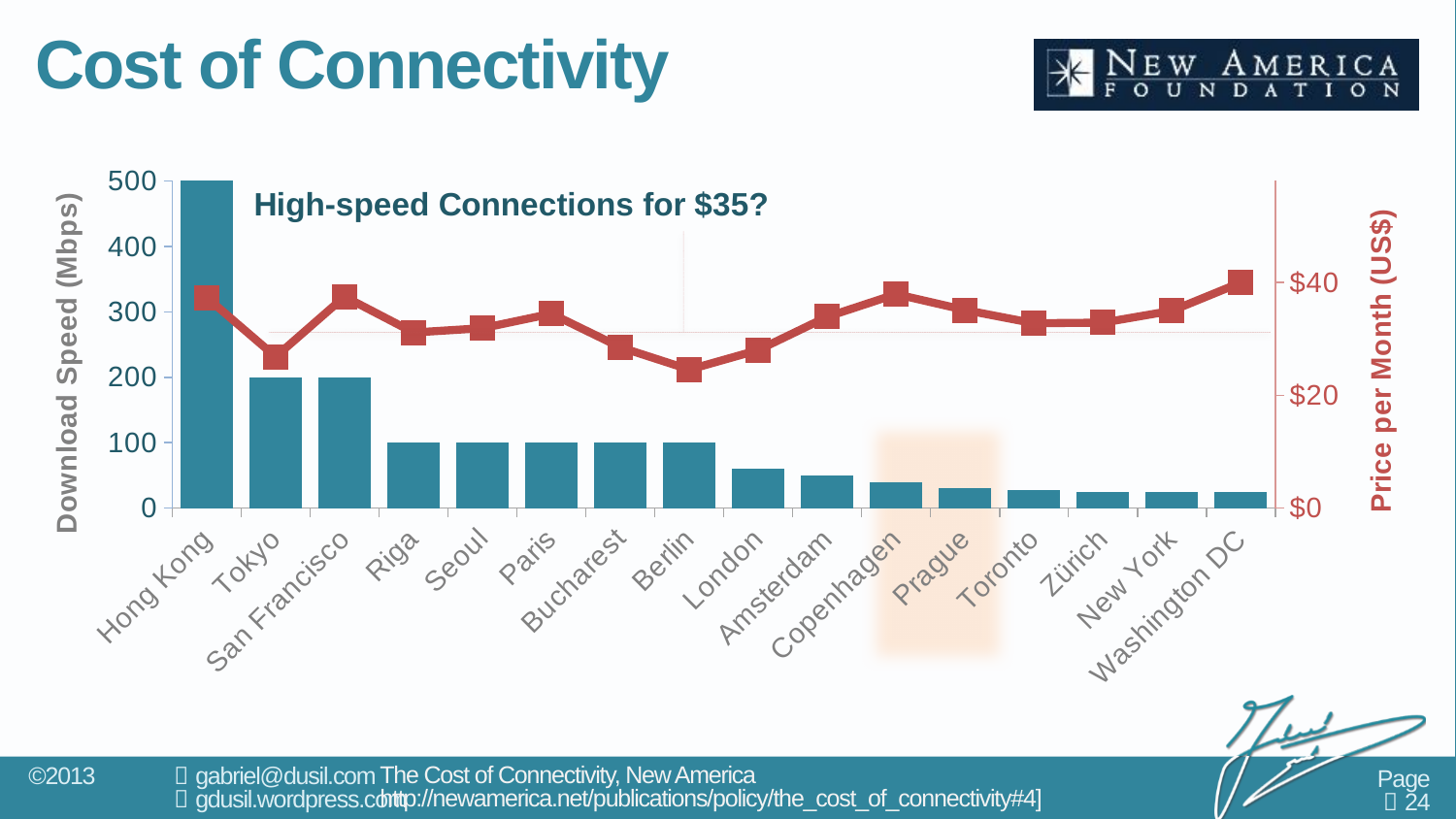
What is the download speed for Riga? 100 Mbps Do the download speed bars rise or fall from left to right? Fall What is the difference in download speed between Hong Kong and Tokyo? 300 Mbps Which city has the highest download speed? Hong Kong Which has a higher download speed, San Francisco or Berlin? San Francisco Is the price per month for Washington DC greater or less than $20? greater Is the download speed for London greater or less than 100? less What is the download speed for Tokyo? 200 Mbps How many cities are shown on the x axis? 16 What is the download speed for Hong Kong? 500 Mbps Is the price per month for Berlin greater or less than $40? less What kind of chart is this? Combined bar and line chart